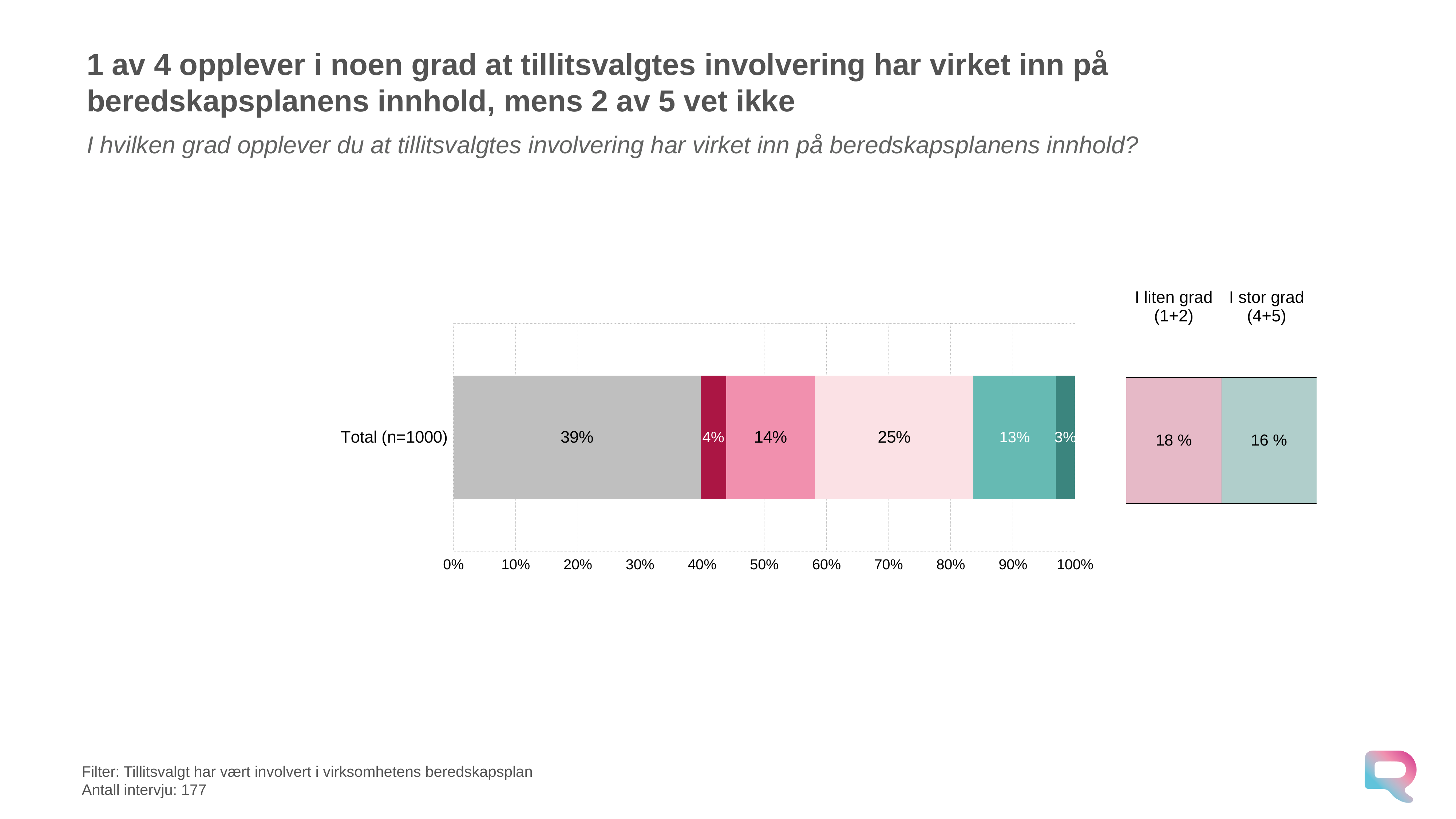
Which is larger, 'I liten grad (1+2)' or 'I stor grad (4+5)'? I liten grad (1+2) What is the label of the single bar in the chart? Total (n=1000) What is the difference between the light pink segment (25%) and the pink segment (14%) of the Total bar? 11 percentage points What is the value of the dark teal (rightmost) segment of the Total (n=1000) bar? 3% Which segment of the Total (n=1000) bar has the largest value? The grey segment, 39% What is the value of the light pink (middle) segment of the Total (n=1000) bar? 25% How many segments make up the stacked bar for Total (n=1000)? 6 What value is shown in the box labelled 'I liten grad (1+2)'? 18 % How many categories (bars) does the chart show? 1 What kind of chart is shown on the slide? Stacked bar chart What is the value of the grey (leftmost) segment of the Total (n=1000) bar? 39% Which segment of the Total (n=1000) bar has the smallest value? The dark teal segment, 3%